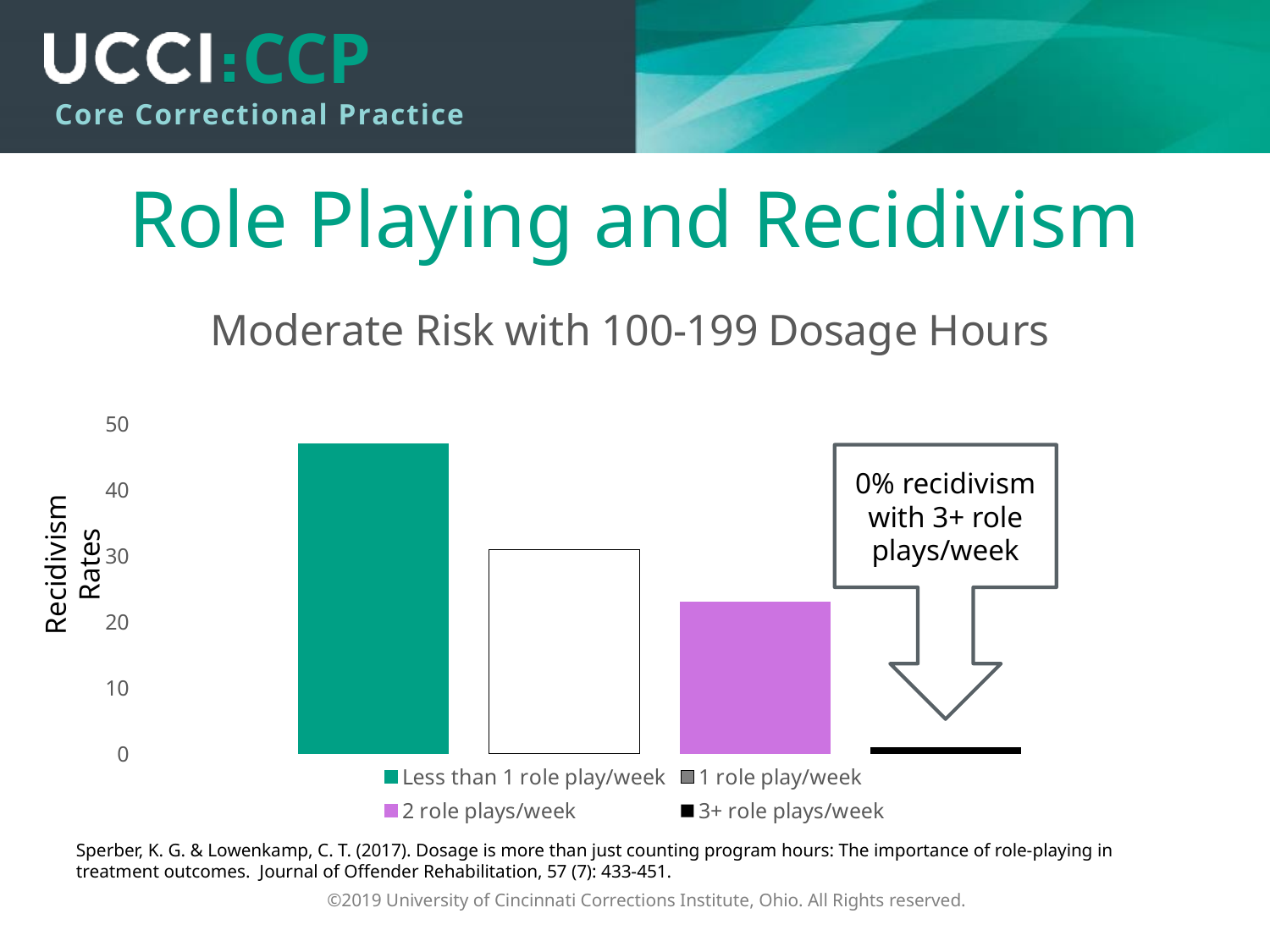
Which has a higher recidivism rate, Less than 1 role play/week or 2 role plays/week? Less than 1 role play/week What is the title of the chart? Moderate Risk with 100-199 Dosage Hours What is the recidivism rate for 3+ role plays/week? 0% Is the recidivism rate for 1 role play/week greater or less than 40? less Which role-play frequency has the lowest recidivism rate? 3+ role plays/week Is the recidivism rate for Less than 1 role play/week greater or less than 40? greater Is the recidivism rate for 2 role plays/week greater or less than 30? less What kind of chart is shown on the slide? bar chart Do recidivism rates rise or fall as the number of role plays per week increases? fall Which role-play frequency has the highest recidivism rate? Less than 1 role play/week What is the label on the vertical axis of the chart? Recidivism Rates How many series does the chart legend list? 4